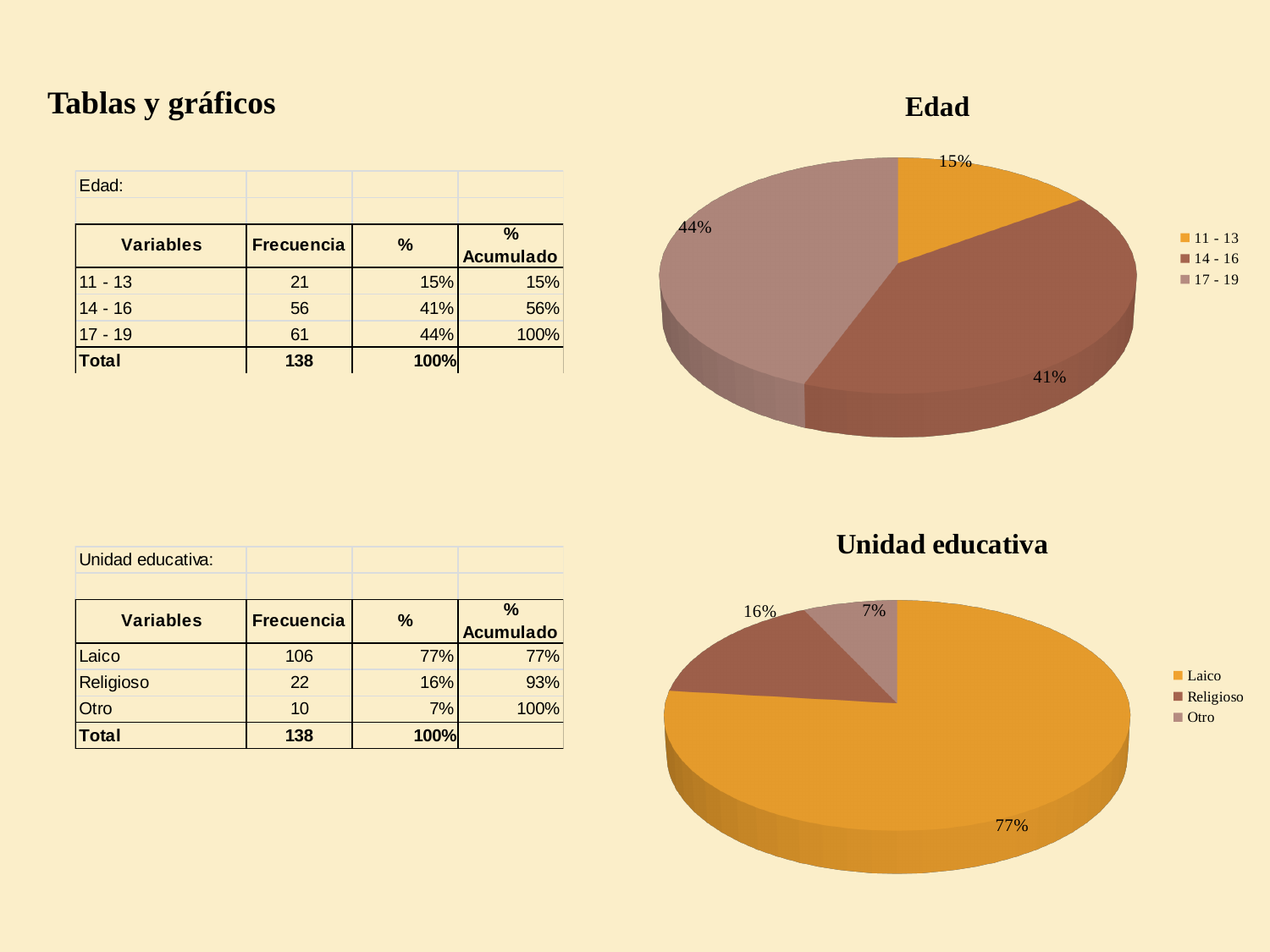
In the 'Edad' chart, how many categories does the legend list? 3 In the 'Unidad educativa' chart, what colour is the Laico slice? orange In the 'Unidad educativa' chart, which category has the smallest slice? Otro In the 'Edad' chart, which category has the smallest slice? 11 - 13 In the 'Edad' chart, what share of the pie does the 11 - 13 slice represent? 15% In the 'Unidad educativa' chart, which slice is larger, Religioso or Otro? Religioso What kind of chart is the 'Unidad educativa' chart? pie chart In the 'Edad' chart, what share of the pie does the 17 - 19 slice represent? 44% In the 'Edad' chart, which category has the largest slice? 17 - 19 In the 'Edad' chart, what is the difference in percentage points between the 14 - 16 slice and the 11 - 13 slice? 26 In the 'Unidad educativa' chart, what share of the pie does the Religioso slice represent? 16%